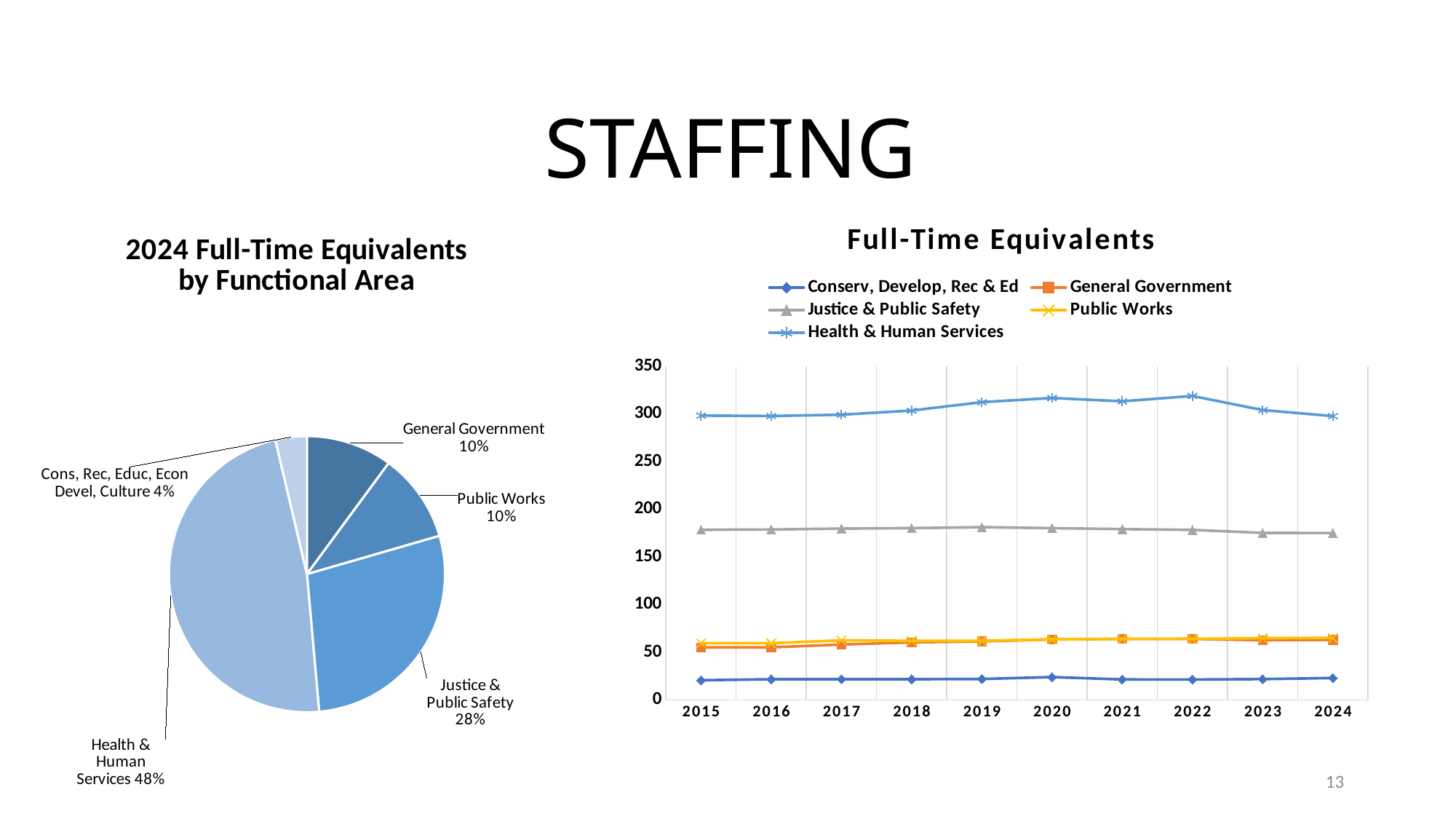
In the pie chart '2024 Full-Time Equivalents by Functional Area', how many slices are there? 5 What kind of chart is the chart on the left of the slide? Pie chart In the pie chart '2024 Full-Time Equivalents by Functional Area', what share does Public Works have? 10% In the pie chart '2024 Full-Time Equivalents by Functional Area', what share does Health & Human Services have? 48% In the 'Full-Time Equivalents' chart on the right, is the value for Conserv, Develop, Rec & Ed in 2020 greater or less than 50? less In the pie chart '2024 Full-Time Equivalents by Functional Area', what is the difference in percentage points between Justice & Public Safety and General Government? 18 percentage points In the 'Full-Time Equivalents' chart on the right, how many years are shown on the x axis? 10 In the 'Full-Time Equivalents' chart on the right, is the value for Health & Human Services in 2022 greater or less than 300? greater In the 'Full-Time Equivalents' chart on the right, how many series does the legend list? 5 What kind of chart is the 'Full-Time Equivalents' chart on the right of the slide? Line chart In the pie chart '2024 Full-Time Equivalents by Functional Area', which functional area has the smallest slice? Cons, Rec, Educ, Econ Devel, Culture In the pie chart '2024 Full-Time Equivalents by Functional Area', which functional area has the largest slice? Health & Human Services